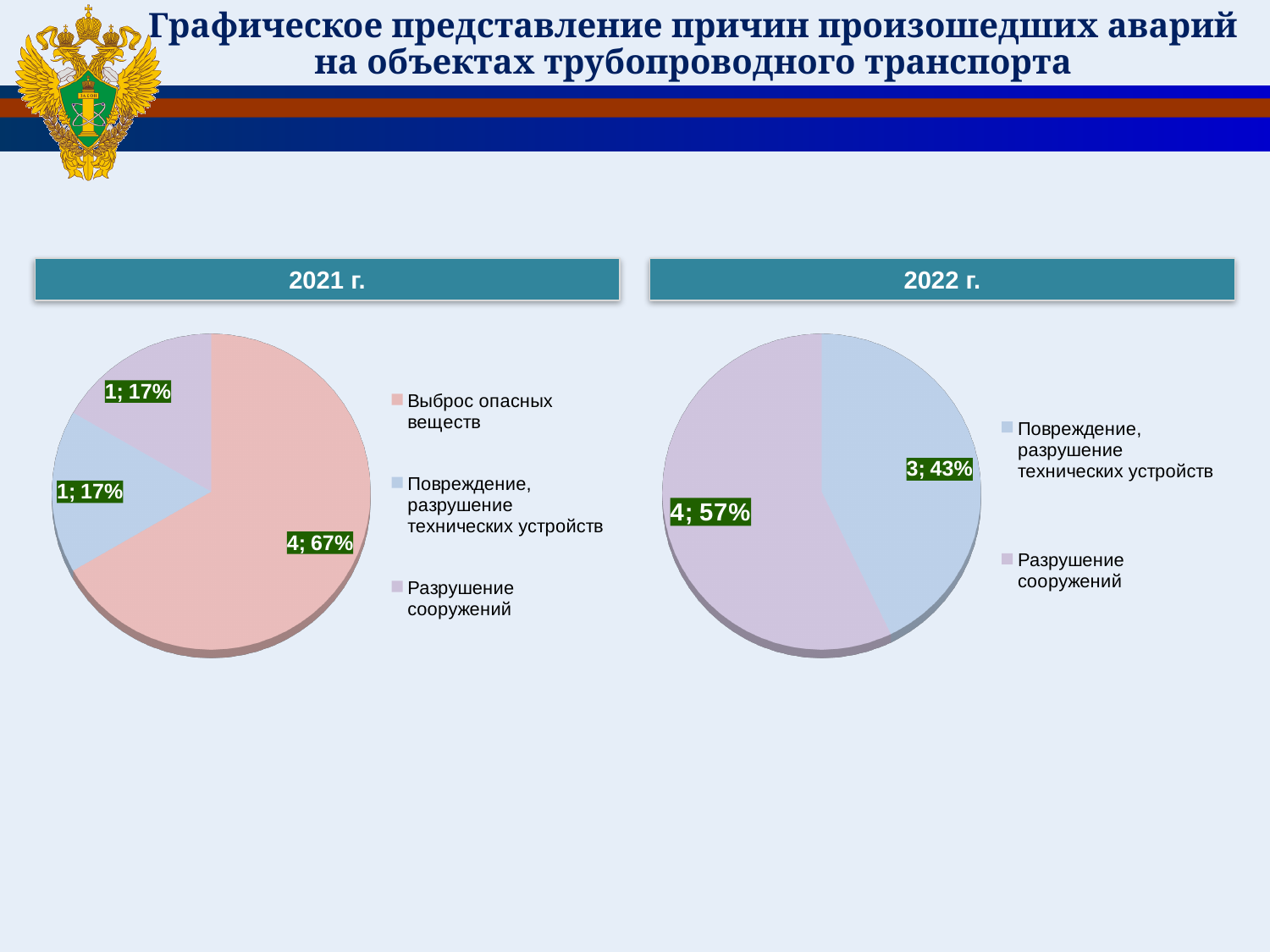
In the 2022 г. chart, what is the value shown for Повреждение, разрушение технических устройств? 3; 43% In the 2022 г. chart, which is larger: Разрушение сооружений or Повреждение, разрушение технических устройств? Разрушение сооружений In the 2021 г. chart, which category has the largest slice? Выброс опасных веществ In the 2021 г. chart, what is the value shown for Выброс опасных веществ? 4; 67% In the 2022 г. chart, what is the difference in count between Разрушение сооружений and Повреждение, разрушение технических устройств? 1 In the 2021 г. chart, what share of the pie does Разрушение сооружений take? 17% What type of chart is used for the 2022 г. data? Pie chart How many categories does the 2022 г. chart show? 2 In the 2022 г. chart, what is the value shown for Разрушение сооружений? 4; 57% In the 2022 г. chart, which category has the smallest slice? Повреждение, разрушение технических устройств In the 2021 г. chart, what colour is the slice for Выброс опасных веществ? Pink How many categories does the 2021 г. chart show? 3